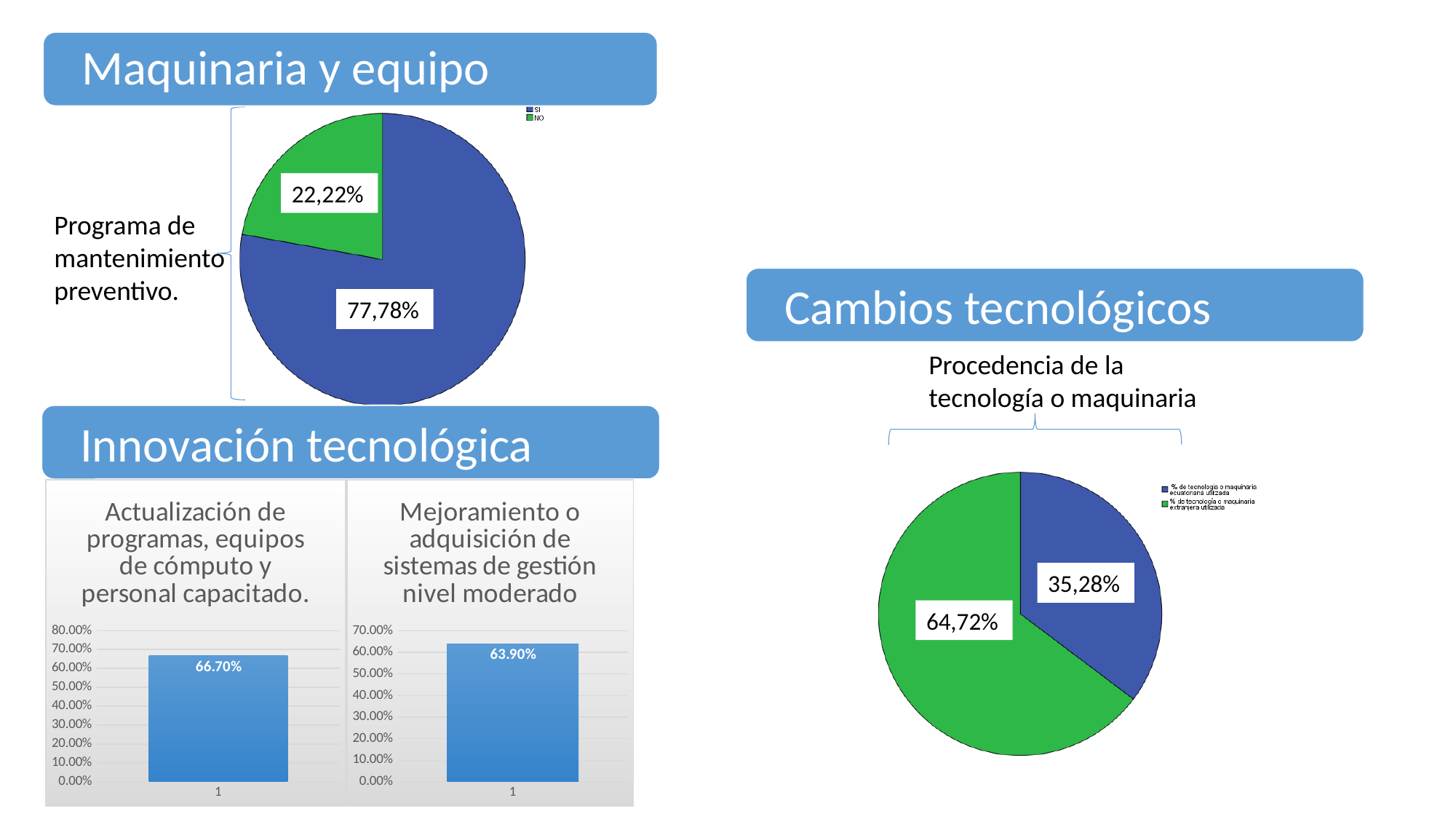
In the 'Actualización de programas, equipos de cómputo y personal capacitado.' chart, what value is shown on the bar? 66.70% In the 'Programa de mantenimiento preventivo' pie chart, what percentage is shown for the SI slice? 77,78% How many slices does the 'Procedencia de la tecnología o maquinaria' pie chart have? 2 Which bar is higher: the one in the 'Actualización de programas, equipos de cómputo y personal capacitado.' chart or the one in the 'Mejoramiento o adquisición de sistemas de gestión nivel moderado' chart? Actualización de programas, equipos de cómputo y personal capacitado. In the 'Procedencia de la tecnología o maquinaria' pie chart, what percentage is shown for the blue slice? 35,28% In the 'Mejoramiento o adquisición de sistemas de gestión nivel moderado' chart, what value is shown on the bar? 63.90% What kind of chart is used for 'Mejoramiento o adquisición de sistemas de gestión nivel moderado'? Bar chart In the 'Programa de mantenimiento preventivo' pie chart, what is the difference between the SI and NO percentages? 55,56% In the 'Programa de mantenimiento preventivo' pie chart, which slice is larger, SI or NO? SI In the 'Procedencia de la tecnología o maquinaria' pie chart, what percentage is shown for the green slice? 64,72% What kind of chart is used for 'Programa de mantenimiento preventivo'? Pie chart In the 'Programa de mantenimiento preventivo' pie chart, what percentage is shown for the NO slice? 22,22%